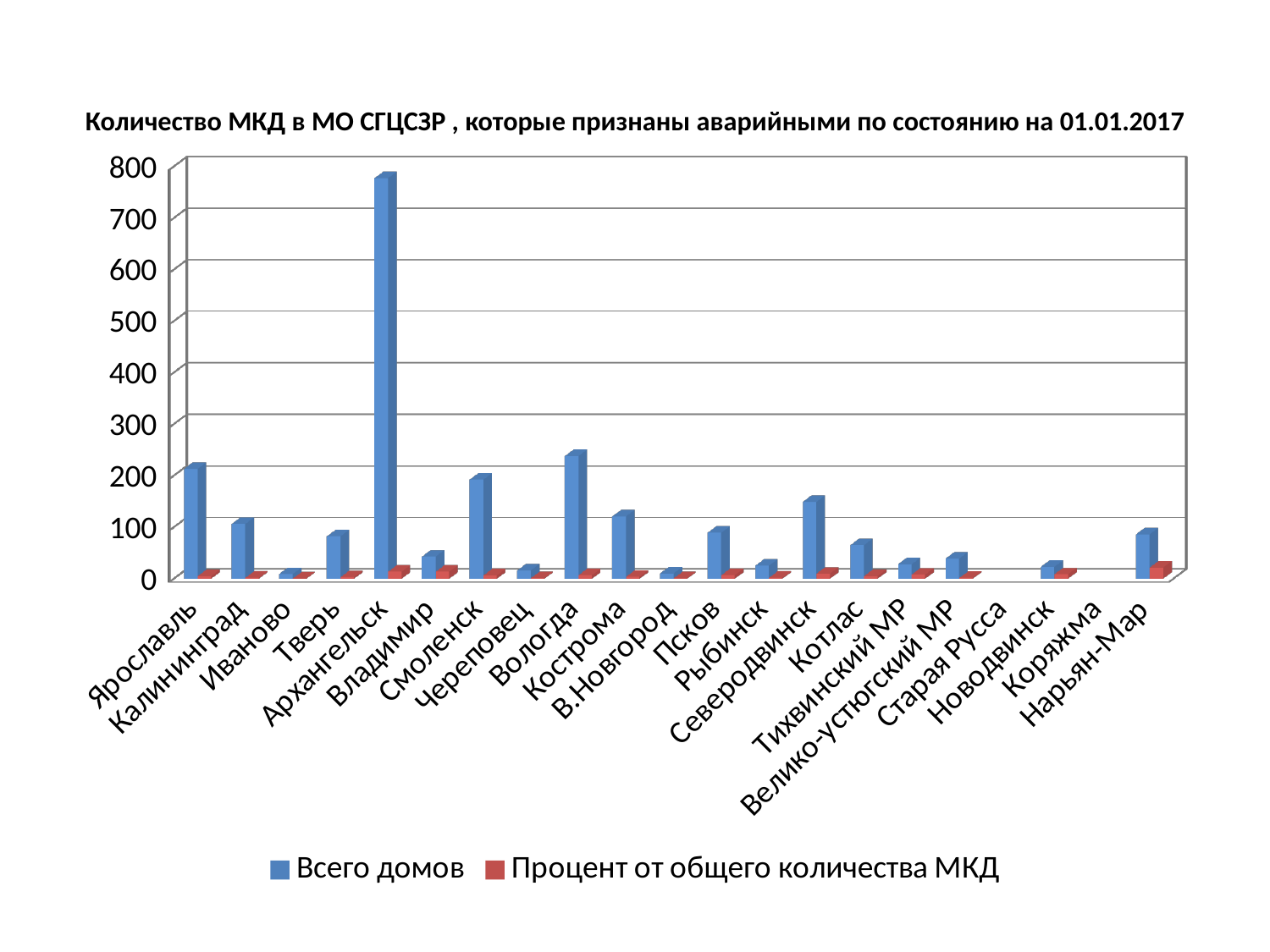
What is the title of the chart? Количество МКД в МО СГЦСЗР , которые признаны аварийными по состоянию на 01.01.2017 How many cities (categories) are shown on the x axis? 21 Is the Всего домов value for Тверь greater or less than 100? less How many series does the legend list? 2 Is the Всего домов value for Архангельск greater or less than 700? greater What kind of chart is shown on the slide? bar chart Which city has the highest value for Всего домов? Архангельск Is the Всего домов value for Северодвинск greater or less than 100? greater Which has a larger Всего домов value, Ярославль or Калининград? Ярославль Which has a larger Всего домов value, Смоленск or Псков? Смоленск